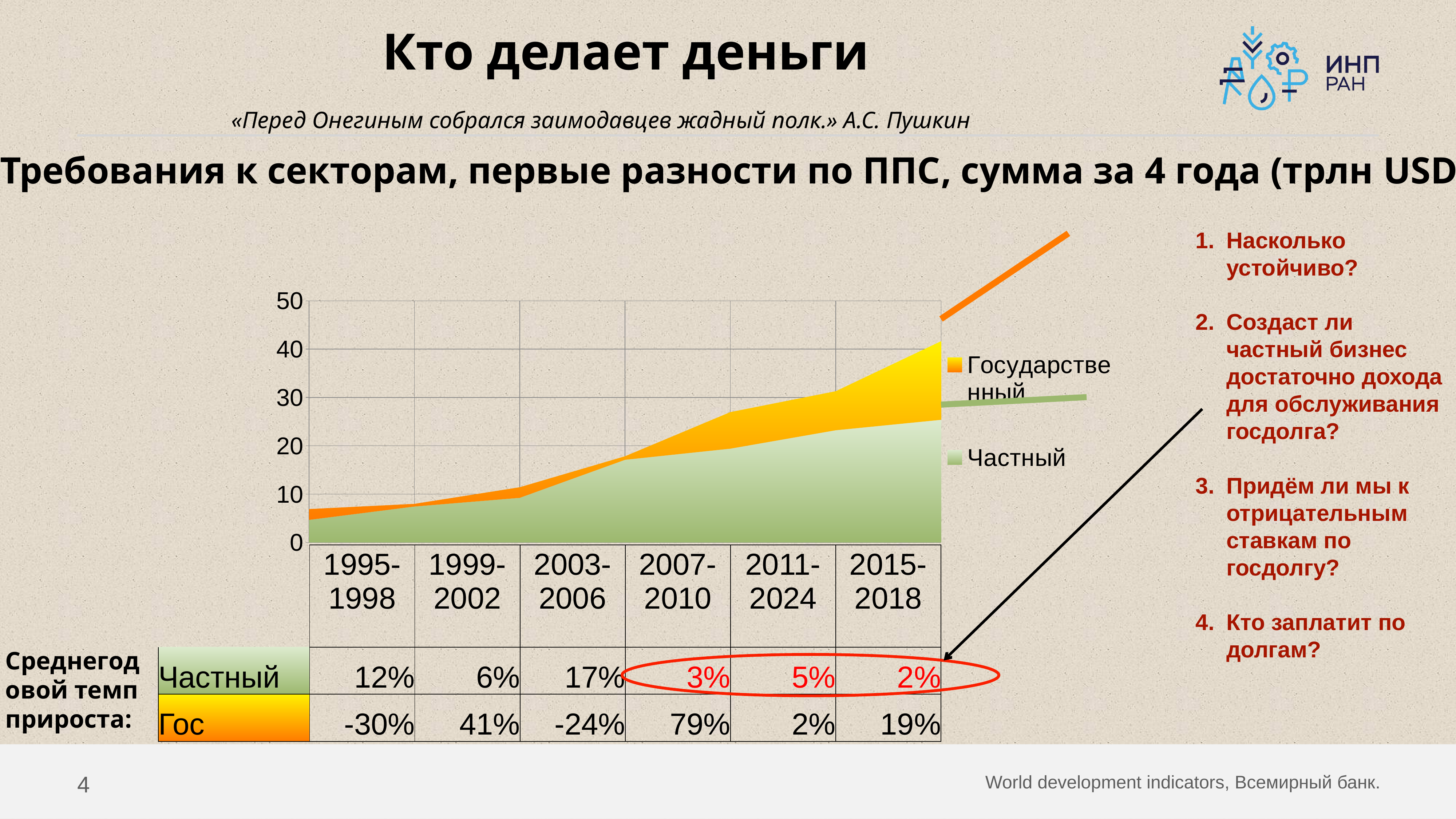
Is the total stacked value in 2007-2010 greater or less than 30? less Is the value for the Частный series in 2015-2018 greater or less than 20? greater In the table below the chart, what is the average annual growth rate for Гос in 2007-2010? 79% Which series is shown in orange in the chart? Государственный How many time periods are shown on the x axis of the chart? 6 In the table below the chart, what is the average annual growth rate for Частный in 2003-2006? 17% Is the value for the Частный series in 1995-1998 greater or less than 10? less How many series does the chart legend list? 2 In the table below the chart, which is larger in 2015-2018: the growth rate for Частный or for Гос? Гос In the table below the chart, which period has the lowest average annual growth rate for Гос? 1995-1998 Do the total values in the chart rise or fall from 1995-1998 to 2015-2018? rise What kind of chart is shown on the slide? area chart